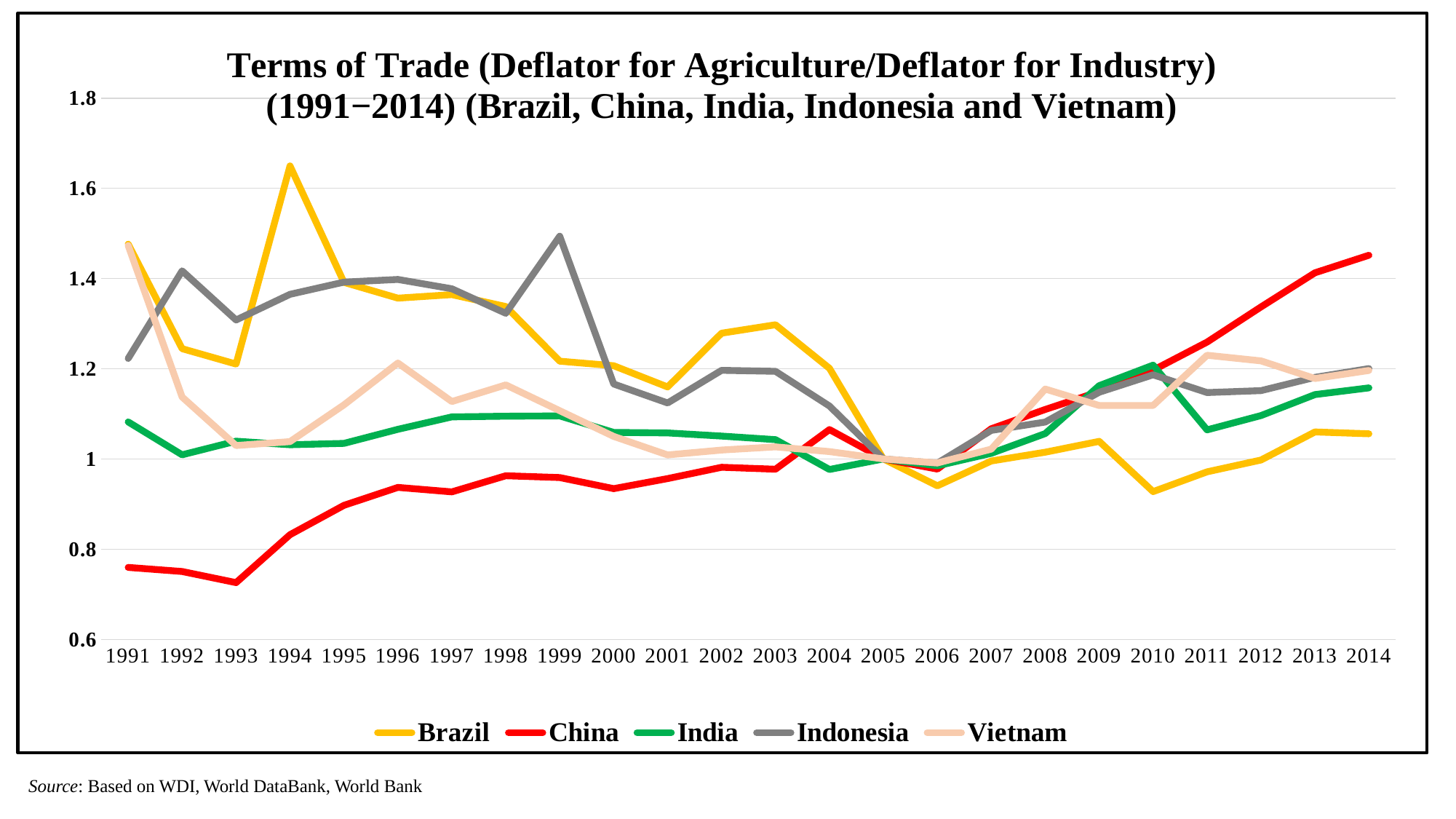
How many series does the legend list? 5 Which country has the highest value in 2014? China How many years are shown along the x axis? 24 Does the value for China rise or fall from 2006 to 2014? rise Which country has the lowest value in 1993? China Is the value for Indonesia in 1999 greater or less than 1.4? greater In 1999, which is higher: Indonesia or Brazil? Indonesia Which country has the highest value in 1994? Brazil Is the value for China in 2014 greater or less than 1.4? greater Is the value for Brazil in 1994 greater or less than 1.6? greater What kind of chart is shown on the slide? line chart